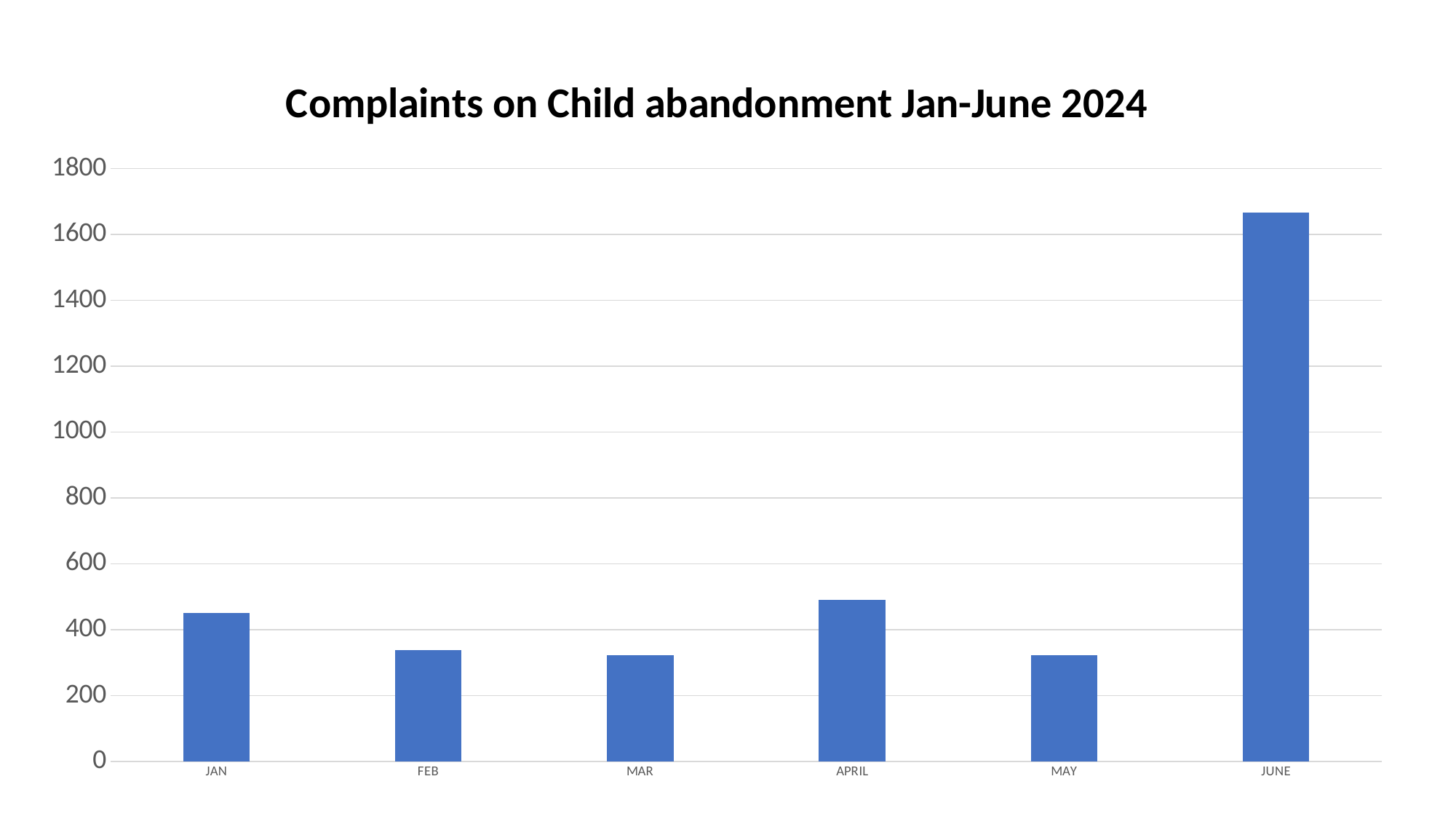
Which is larger, the value for JUNE or the value for APRIL? JUNE Which month has the highest number of complaints? JUNE Is the value for JAN greater or less than 400? greater Is the value for MAY greater or less than 200? greater Is the value for APRIL greater or less than 600? less Which is larger, the value for APRIL or the value for MAR? APRIL Which is larger, the value for JAN or the value for FEB? JAN What kind of chart is shown on the slide? bar chart What is the title of the chart? Complaints on Child abandonment Jan-June 2024 How many months are shown on the x axis of the chart? 6